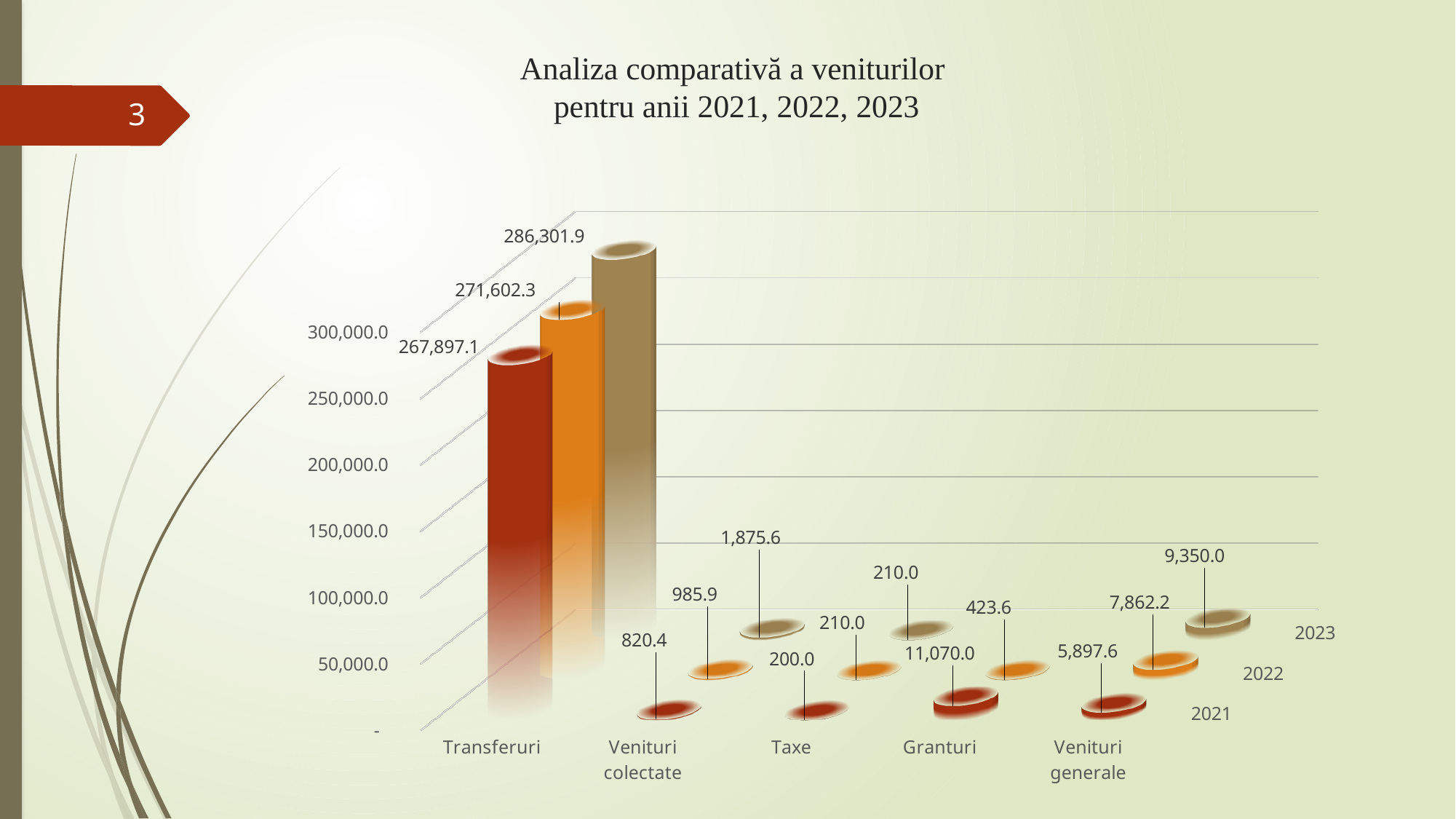
What is the value for Granturi in 2021? 11,070.0 Which category has the lowest value in 2023? Taxe What is the value for Venituri colectate in 2023? 1,875.6 How many years (series) are plotted in the chart? 3 What is the value for Transferuri in 2023? 286,301.9 Which is larger for Granturi: the 2021 value or the 2022 value? 2021 How many categories are shown on the x axis? 5 What kind of chart is shown on the slide? Bar chart What is the value for Venituri generale in 2022? 7,862.2 Which category has the highest value in 2021? Transferuri What is the title of the chart? Analiza comparativă a veniturilor pentru anii 2021, 2022, 2023 What is the difference between the Transferuri values for 2023 and 2022? 14,699.6